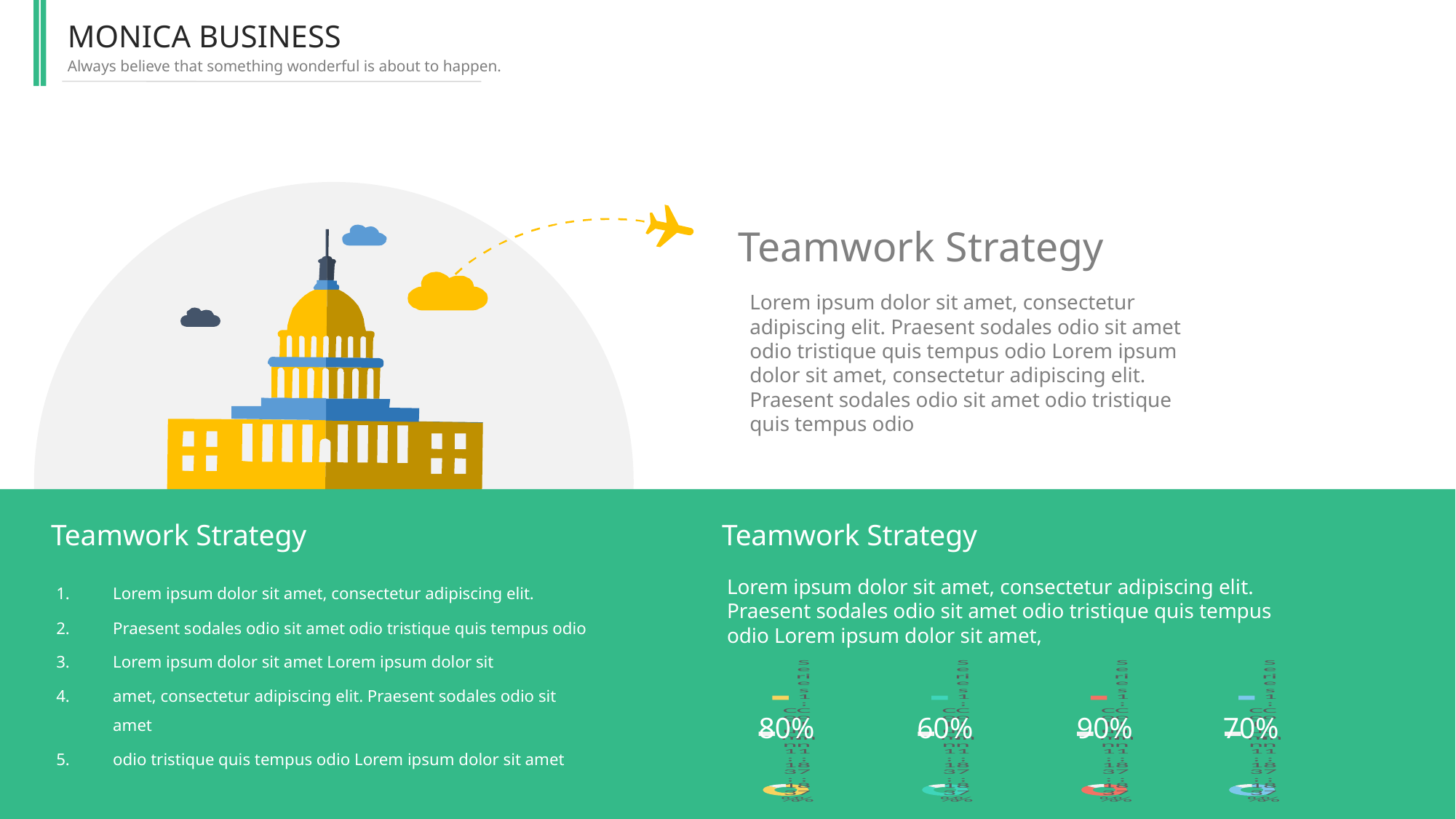
How many small doughnut charts are shown at the bottom right of the slide? 4 What percentage is shown on the fourth (rightmost) doughnut chart at the bottom right of the slide? 70% Among the four doughnut charts at the bottom right, which one shows the highest percentage? The third chart (90%) What colour is the third doughnut chart (the one showing 90%)? Red What percentage is shown on the second doughnut chart at the bottom right of the slide? 60% What type of chart is used for the four small charts at the bottom right of the slide? Doughnut chart What is the difference between the percentage on the third doughnut chart and the percentage on the second doughnut chart? 30% Which is larger: the percentage on the first doughnut chart or the percentage on the fourth doughnut chart? The first chart (80%) What percentage is shown on the third doughnut chart at the bottom right of the slide? 90% Among the four doughnut charts at the bottom right, which one shows the lowest percentage? The second chart (60%) What colour is the first doughnut chart (the one showing 80%)? Yellow What percentage is shown on the first (leftmost) doughnut chart at the bottom right of the slide? 80%